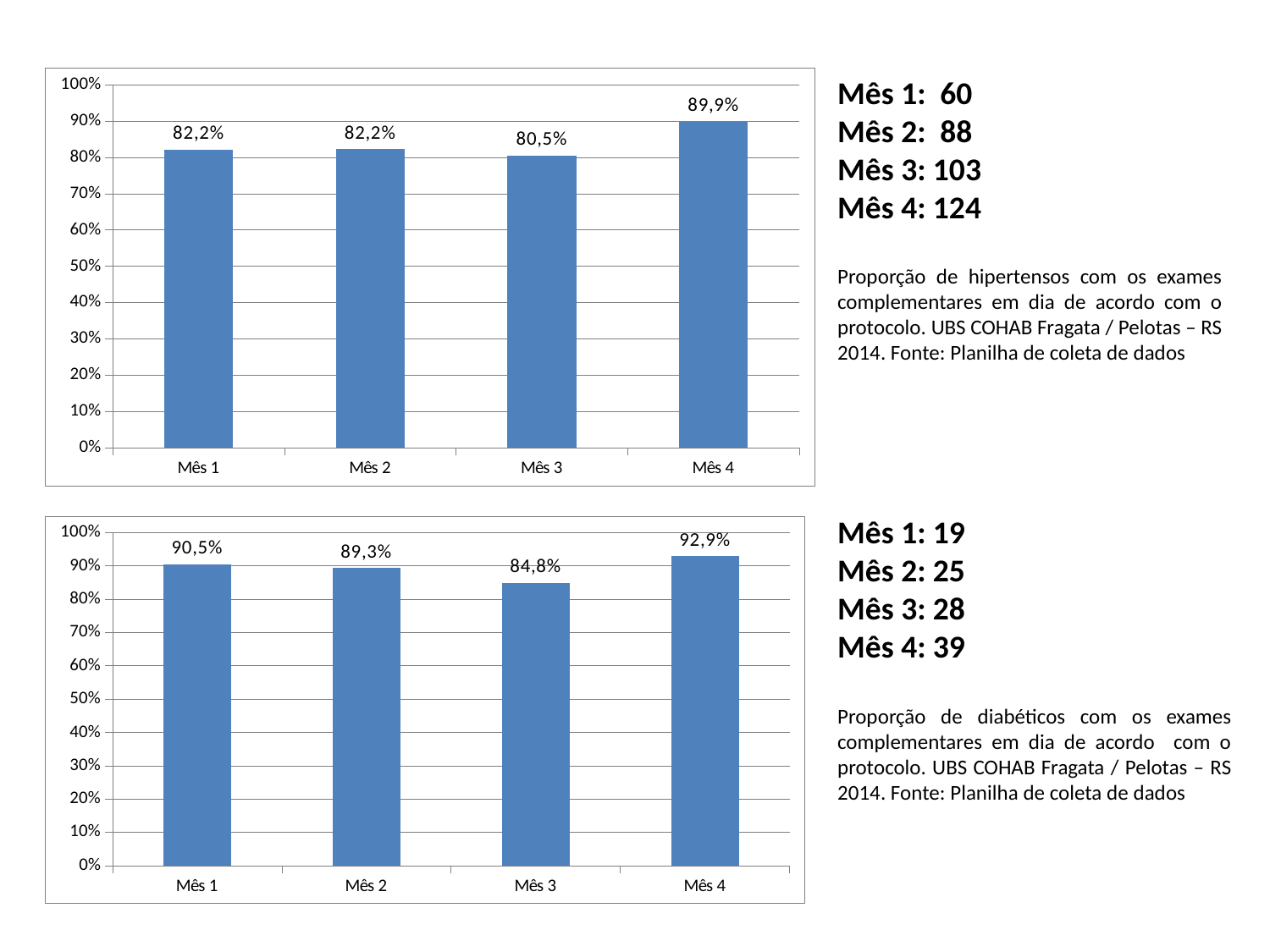
In the top chart, which month has the highest value? Mês 4 In the bottom chart, what is the value for Mês 3? 84,8% In the top chart, what is the value for Mês 3? 80,5% In the top chart, how many bars are plotted? 4 In the bottom chart, what is the difference between the values for Mês 4 and Mês 3? 8,1 percentage points In the bottom chart, what is the value for Mês 1? 90,5% In the top chart, what is the value for Mês 4? 89,9% In the bottom chart, which month has the highest value? Mês 4 In the bottom chart, which is larger, the value for Mês 1 or Mês 2? Mês 1 In the top chart, what is the difference between the values for Mês 4 and Mês 3? 9,4 percentage points What kind of chart is the bottom chart? Bar chart In the top chart, which month has the lowest value? Mês 3